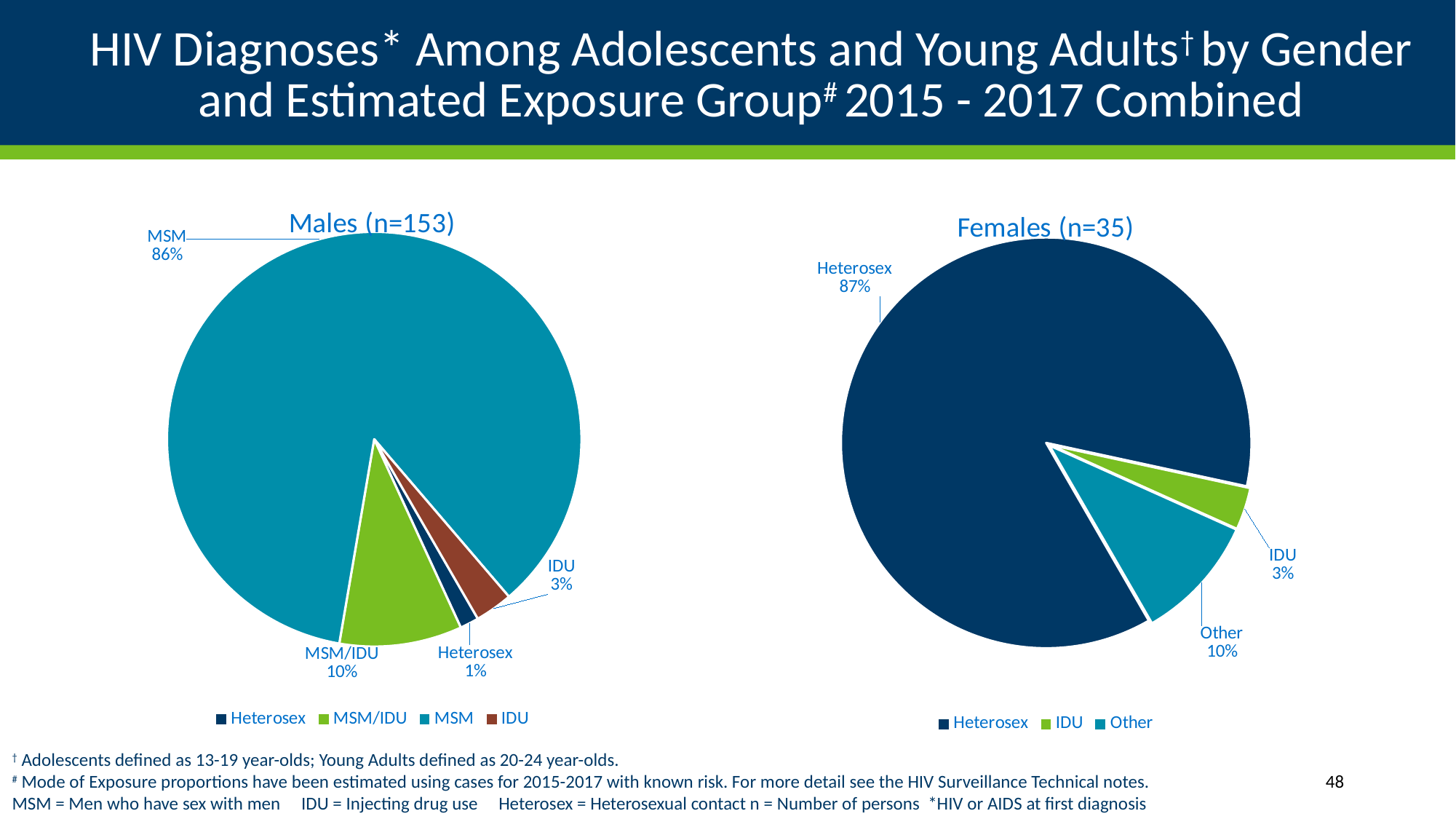
What kind of chart is used for the Males (n=153) data? Pie chart In the Females (n=35) chart, which exposure group has the largest share? Heterosex In the Males (n=153) chart, what is the difference in percentage points between the MSM/IDU and IDU shares? 7 What is the title of the chart on the right side of the slide? Females (n=35) In the Males (n=153) chart, which exposure group has the smallest share? Heterosex In the Females (n=35) chart, what share of diagnoses is attributed to Other? 10% How many entries does the legend of the Females (n=35) chart list? 3 In the Females (n=35) chart, what share of diagnoses is attributed to Heterosex? 87% In the Males (n=153) chart, what share of diagnoses is attributed to MSM? 86% In the Males (n=153) chart, what share of diagnoses is attributed to MSM/IDU? 10% How many slices does the Males (n=153) pie chart have? 4 In the Females (n=35) chart, which is larger, the Other share or the IDU share? Other